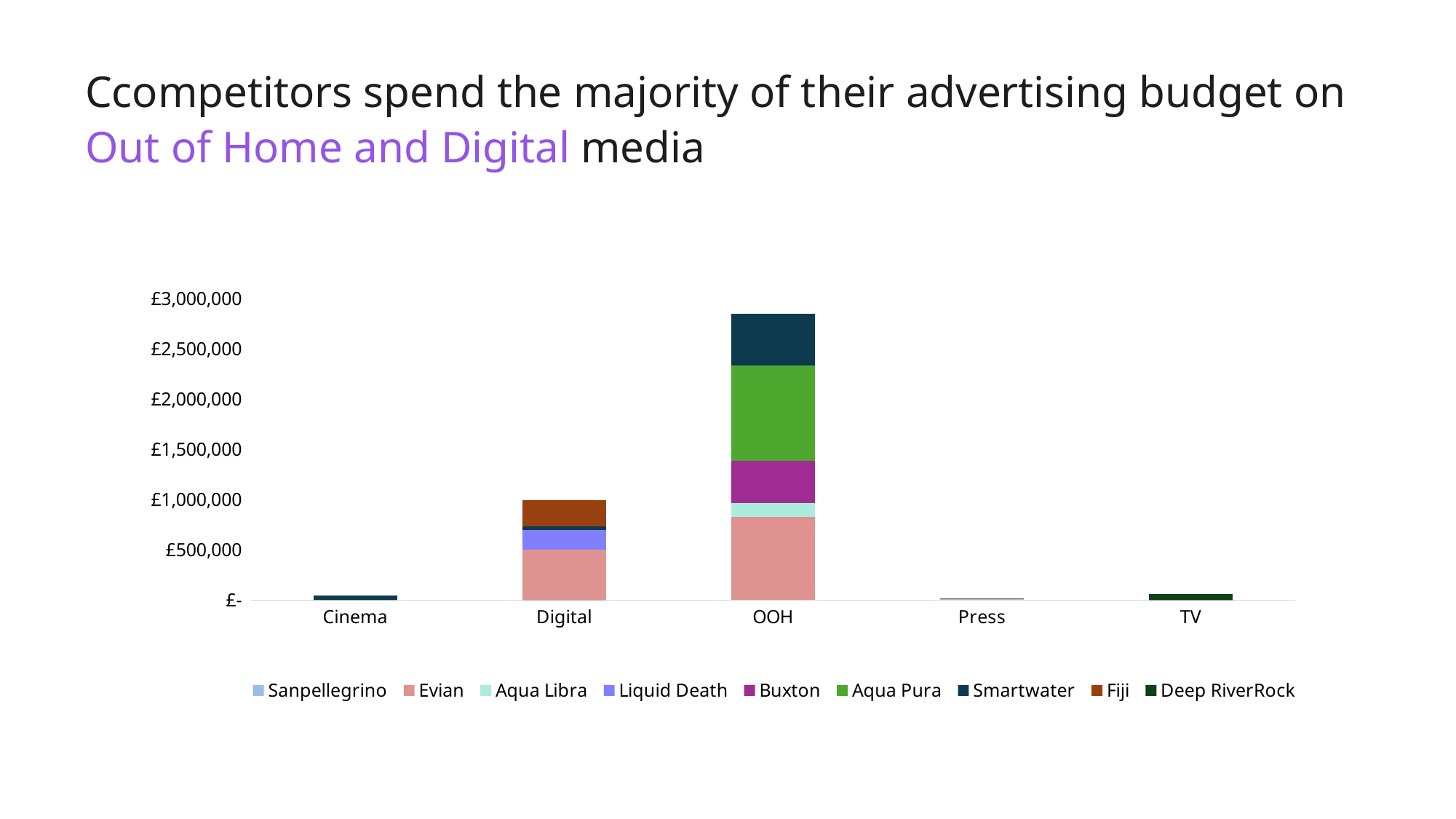
Which series forms the top segment of the Digital bar? Fiji How many media categories are shown on the x axis of the chart? 5 Which media category has the highest total advertising spend? OOH What kind of chart is shown on the slide? Stacked bar chart How many series does the chart's legend list? 9 Which has the larger total spend, Cinema or Digital? Digital Is the total value for Cinema greater or less than £500,000? less Which series forms the bottom segment of the OOH bar? Evian Is the total value for Digital greater or less than £500,000? greater Which has the larger total spend, Digital or OOH? OOH Is the total value for OOH greater or less than £2,500,000? greater